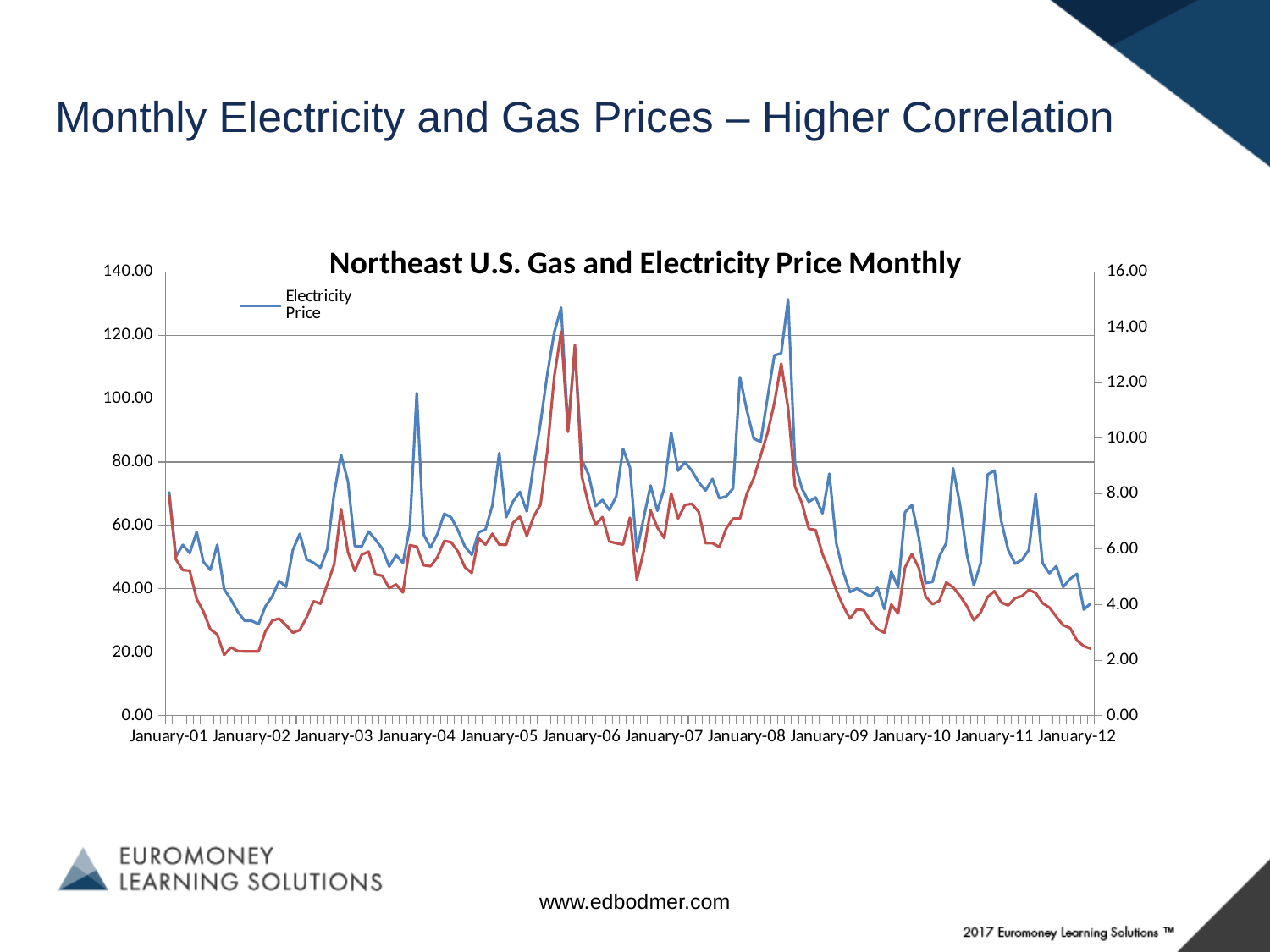
What is the title of the chart? Northeast U.S. Gas and Electricity Price Monthly Which is larger, the Electricity Price at January-01 or at January-12? January-01 Is the Electricity Price at January-03 greater or less than 60? greater Is the Electricity Price at January-01 greater or less than 60? greater What is the highest value shown on the right-hand vertical axis? 16.00 Is the Electricity Price at January-10 greater or less than 60? greater What kind of chart is shown on the slide? line chart From January-01 to January-02, does the Electricity Price rise or fall overall? fall How many date labels are shown along the x axis? 12